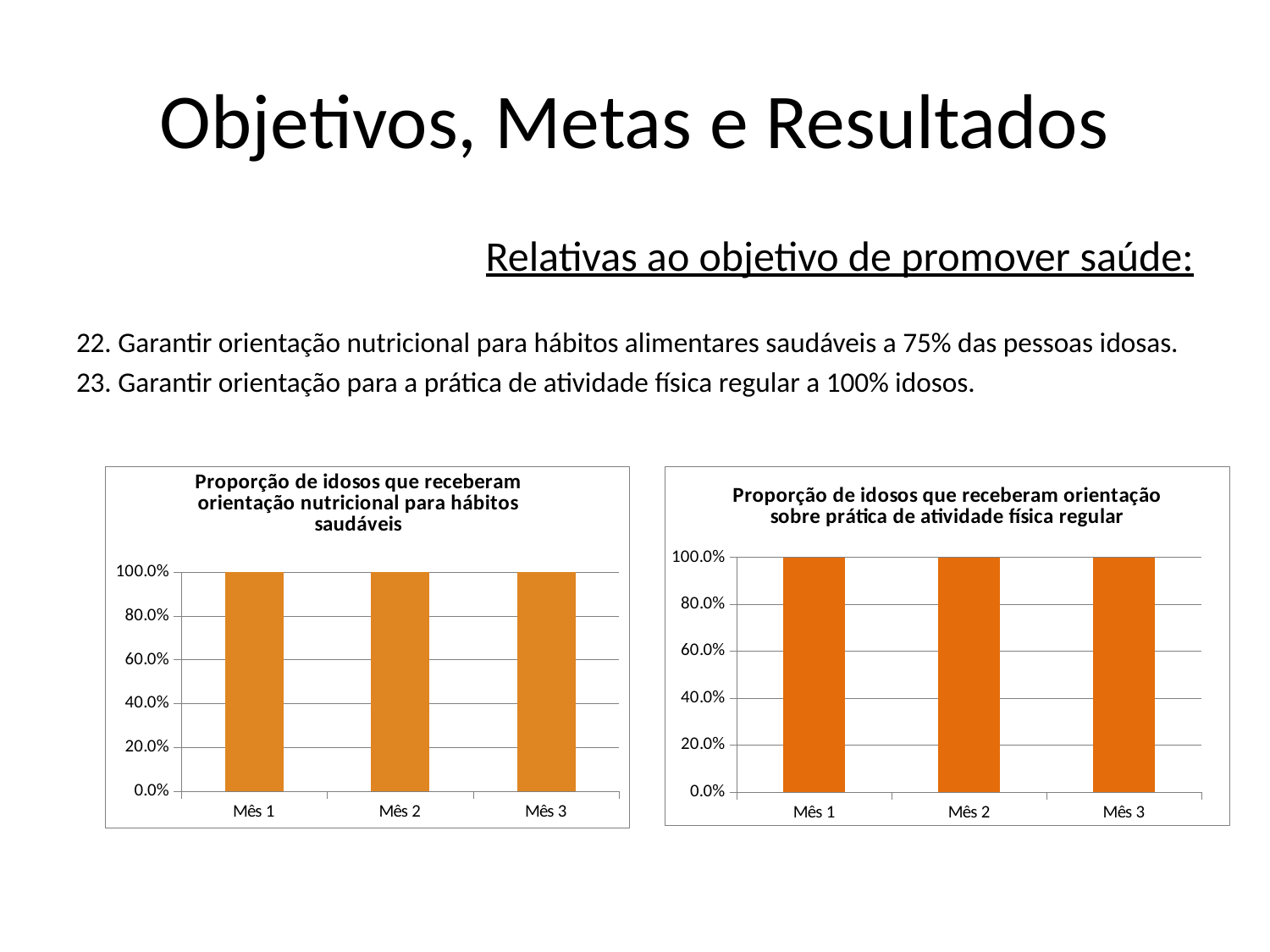
In the right chart, is the value for Mês 1 greater or less than 80.0%? greater In the right chart, what is the value for Mês 2? 100.0% In the left chart, what is the difference between the values for Mês 1 and Mês 3? 0.0% In the left chart, what is the value for Mês 2? 100.0% What kind of chart is the right chart? bar chart What is the title of the right chart? Proporção de idosos que receberam orientação sobre prática de atividade física regular How many categories are shown on the x axis of the left chart? 3 In the left chart, do the values rise, fall or stay the same from Mês 1 to Mês 3? stay the same In the left chart (Proporção de idosos que receberam orientação nutricional para hábitos saudáveis), what is the value for Mês 1? 100.0% How many bars are plotted in the right chart? 3 In the right chart (Proporção de idosos que receberam orientação sobre prática de atividade física regular), what is the value for Mês 3? 100.0% What kind of chart is the left chart? bar chart